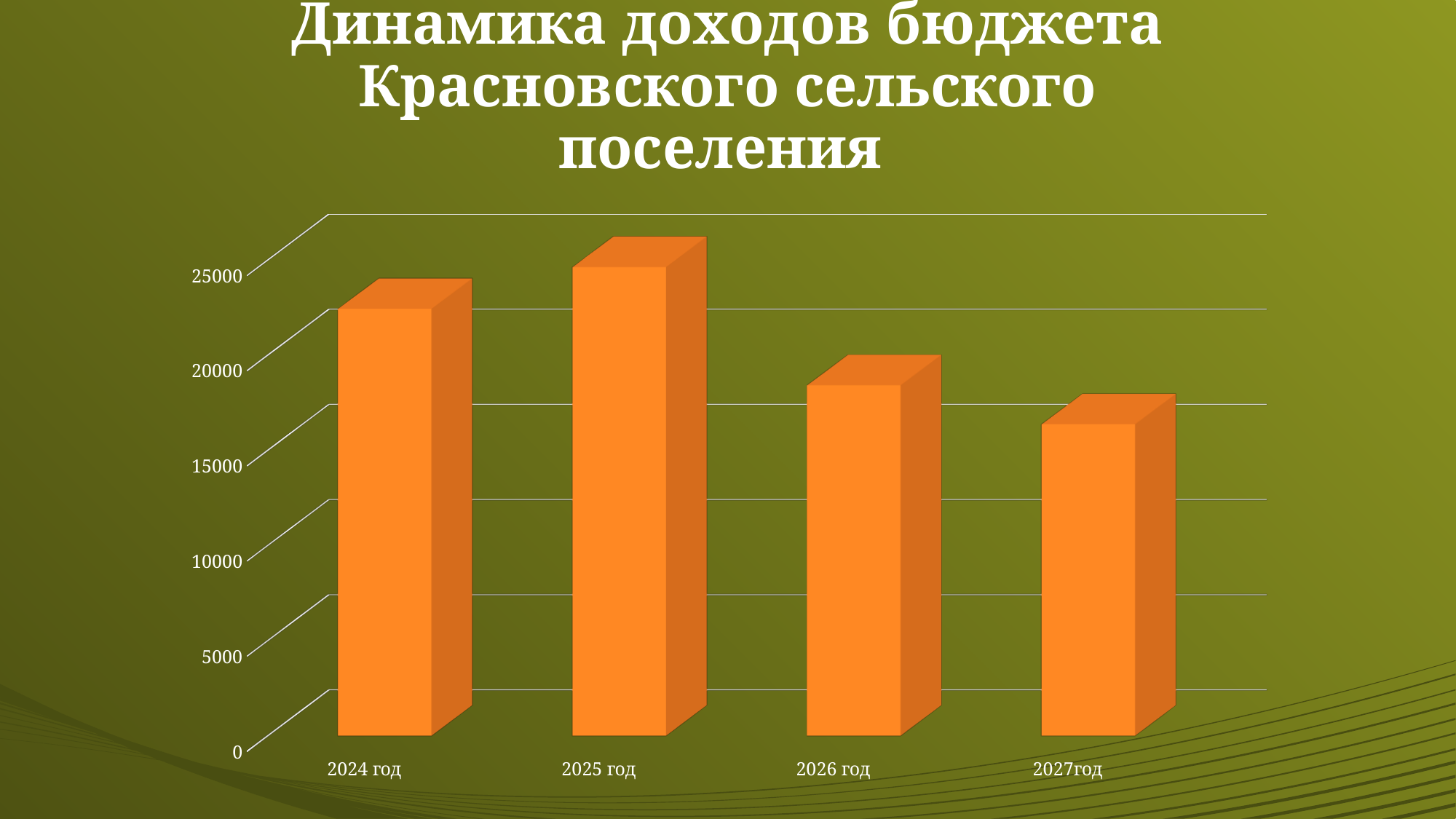
Is the value for 2024 год greater or less than 20000? greater What is the title of the chart on the slide? Динамика доходов бюджета Красновского сельского поселения Which year has the lowest bar in the chart? 2027год Is the value for 2025 год greater or less than 20000? greater Is the value for 2027год greater or less than 15000? greater What kind of chart is shown on the slide? bar chart Which bar is taller, 2025 год or 2027год? 2025 год Which bar is taller, 2024 год or 2026 год? 2024 год Do the values rise or fall from 2025 год to 2027год? fall How many categories (years) are shown on the x axis of the chart? 4 Which year has the highest bar in the chart? 2025 год